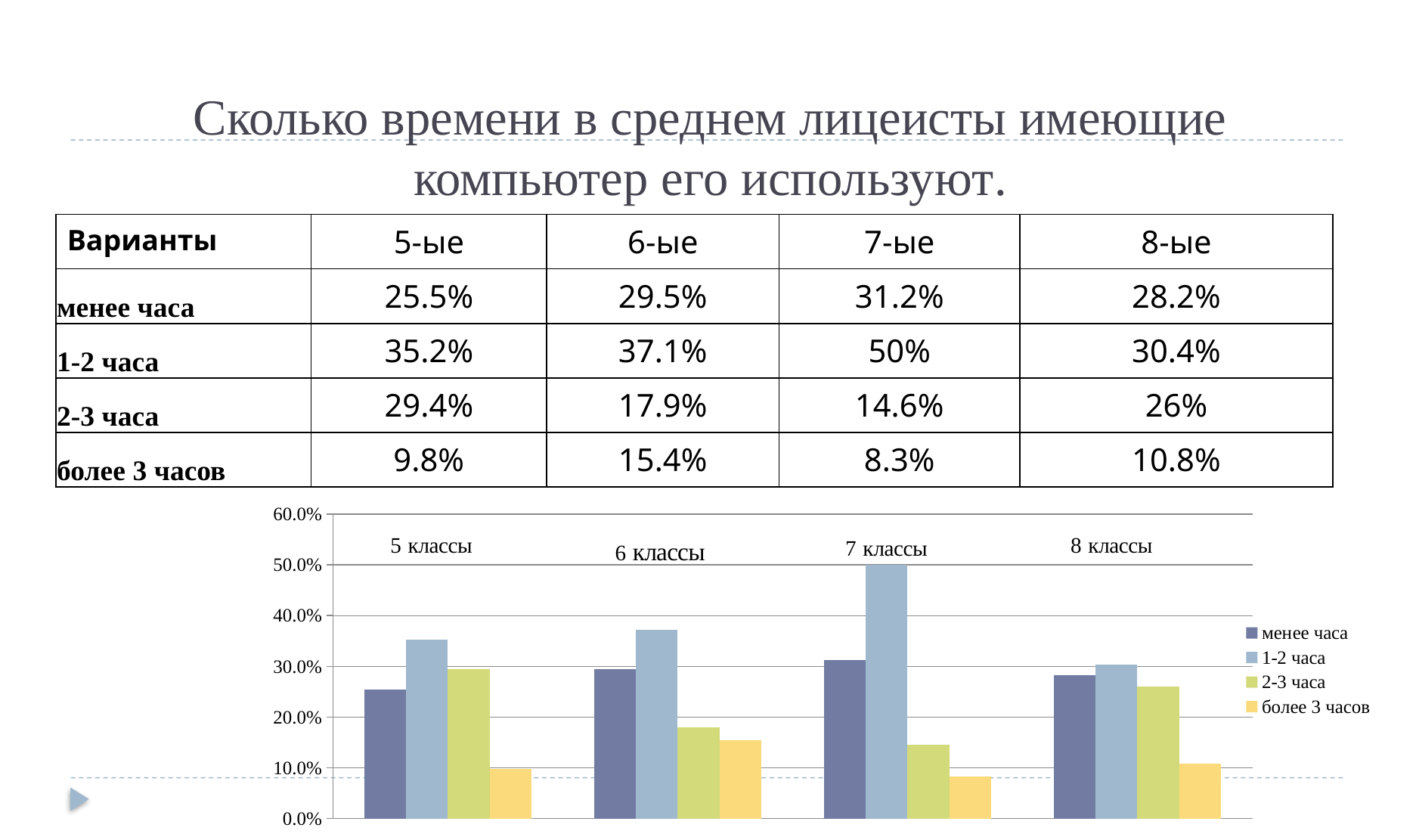
How many class groups are plotted on the x axis of the chart? 4 For 7 классы, what is the difference between the 1-2 часа value and the менее часа value? 18.8% What is the value of the 1-2 часа bar for 7 классы? 50% Is the 2-3 часа value for 8 классы greater or less than 20%? greater Is the 1-2 часа value for 6 классы greater or less than 30%? greater For 5 классы, which is larger: the менее часа bar or the 2-3 часа bar? 2-3 часа What kind of chart is shown on the slide? bar chart Which class group has the highest 1-2 часа bar? 7 классы Which class group has the lowest более 3 часов bar? 7 классы What is the value of the 2-3 часа bar for 8 классы? 26% What is the first entry listed in the chart legend? менее часа How many series does the chart legend list? 4